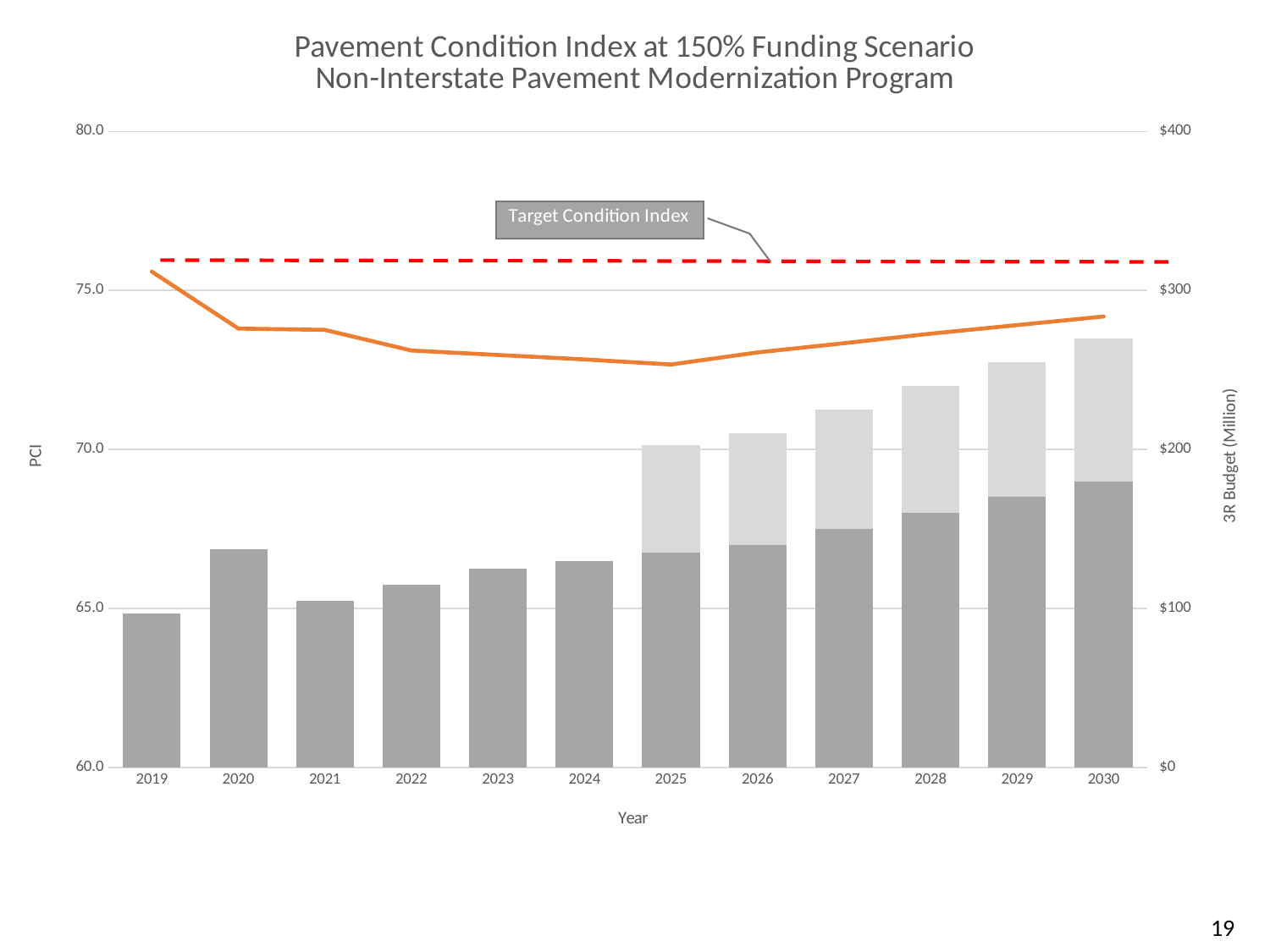
Which year has the tallest bar? 2030 Is the PCI value of the orange line in 2019 greater or less than 75.0? greater Is the total bar value for 2019 greater or less than $100 million? less Does the orange PCI line rise or fall from 2019 to 2025? fall What is the title of the chart? Pavement Condition Index at 150% Funding Scenario Non-Interstate Pavement Modernization Program Is the PCI value of the orange line in 2025 greater or less than 75.0? less How many years are shown along the x axis? 12 Which is larger, the bar for 2030 or the bar for 2019? 2030 What kind of chart is shown on the slide? A bar chart combined with a line chart What does the red dashed line represent? Target Condition Index Which year has the shortest bar? 2019